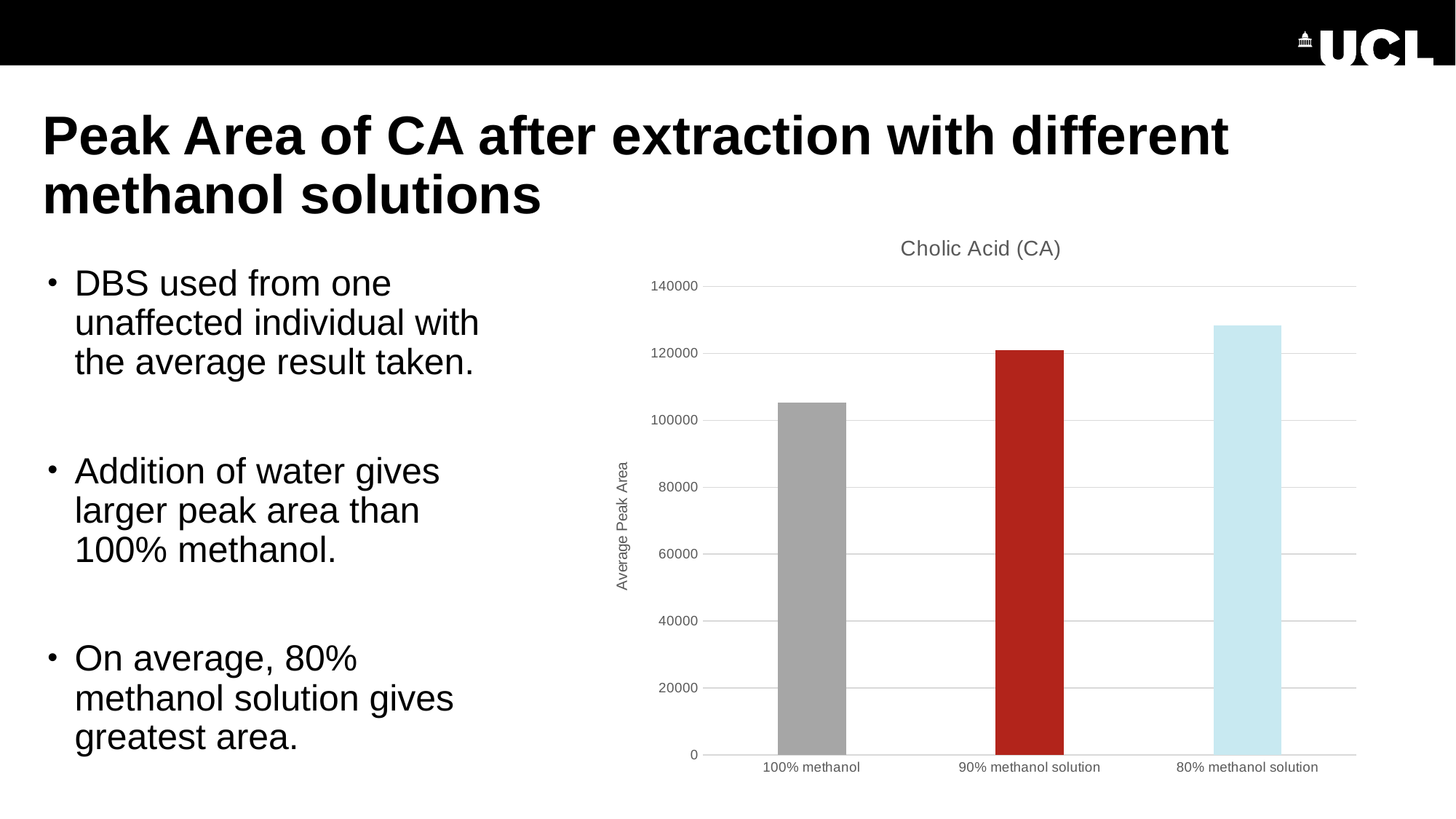
Which category has the highest average peak area? 80% methanol solution Is the value for 80% methanol solution greater or less than 140000? less Is the value for 100% methanol greater or less than 100000? greater Which category has the lowest average peak area? 100% methanol What is the title of the chart? Cholic Acid (CA) What is the label of the vertical axis of the chart? Average Peak Area How many categories are shown on the x axis of the chart? 3 Do the values rise or fall moving from left to right along the x axis? rise Is the value for 100% methanol greater or less than 120000? less Which is larger, the value for 90% methanol solution or the value for 100% methanol? 90% methanol solution What type of chart is shown on the slide? bar chart